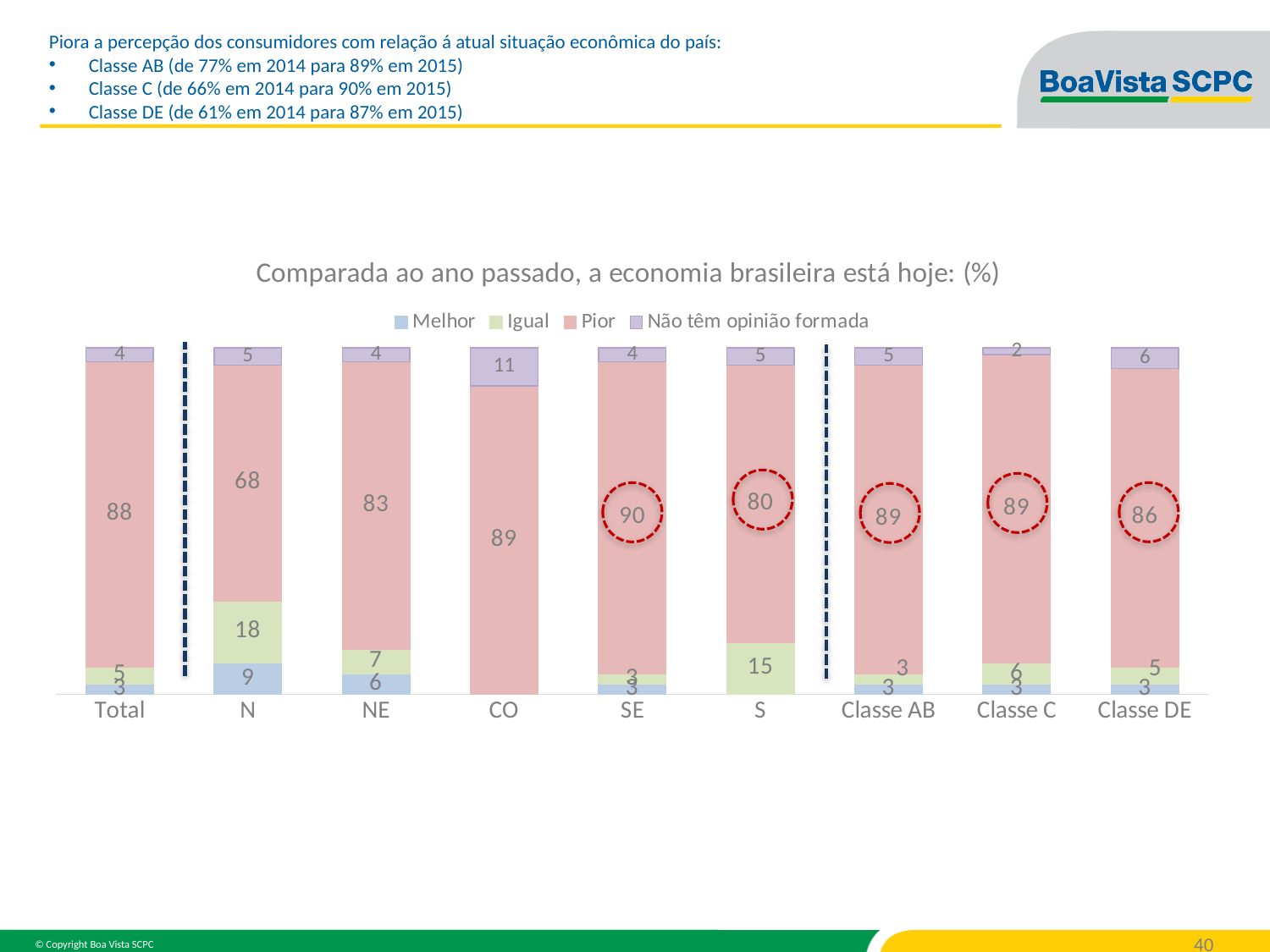
Which category has the highest value for 'Não têm opinião formada'? CO Which category has the highest value for 'Pior'? SE Which has a larger 'Pior' value, NE or Classe DE? Classe DE What is the value of 'Igual' for S? 15 What is the value of 'Pior' for N? 68 How many series does the legend list? 4 What is the difference between the 'Pior' value for SE and the 'Pior' value for N? 22 What kind of chart is shown on the slide? Stacked bar chart Which category has the lowest value for 'Pior'? N What is the value of 'Não têm opinião formada' for CO? 11 How many categories are shown along the x axis? 9 What is the title of the chart? Comparada ao ano passado, a economia brasileira está hoje: (%)